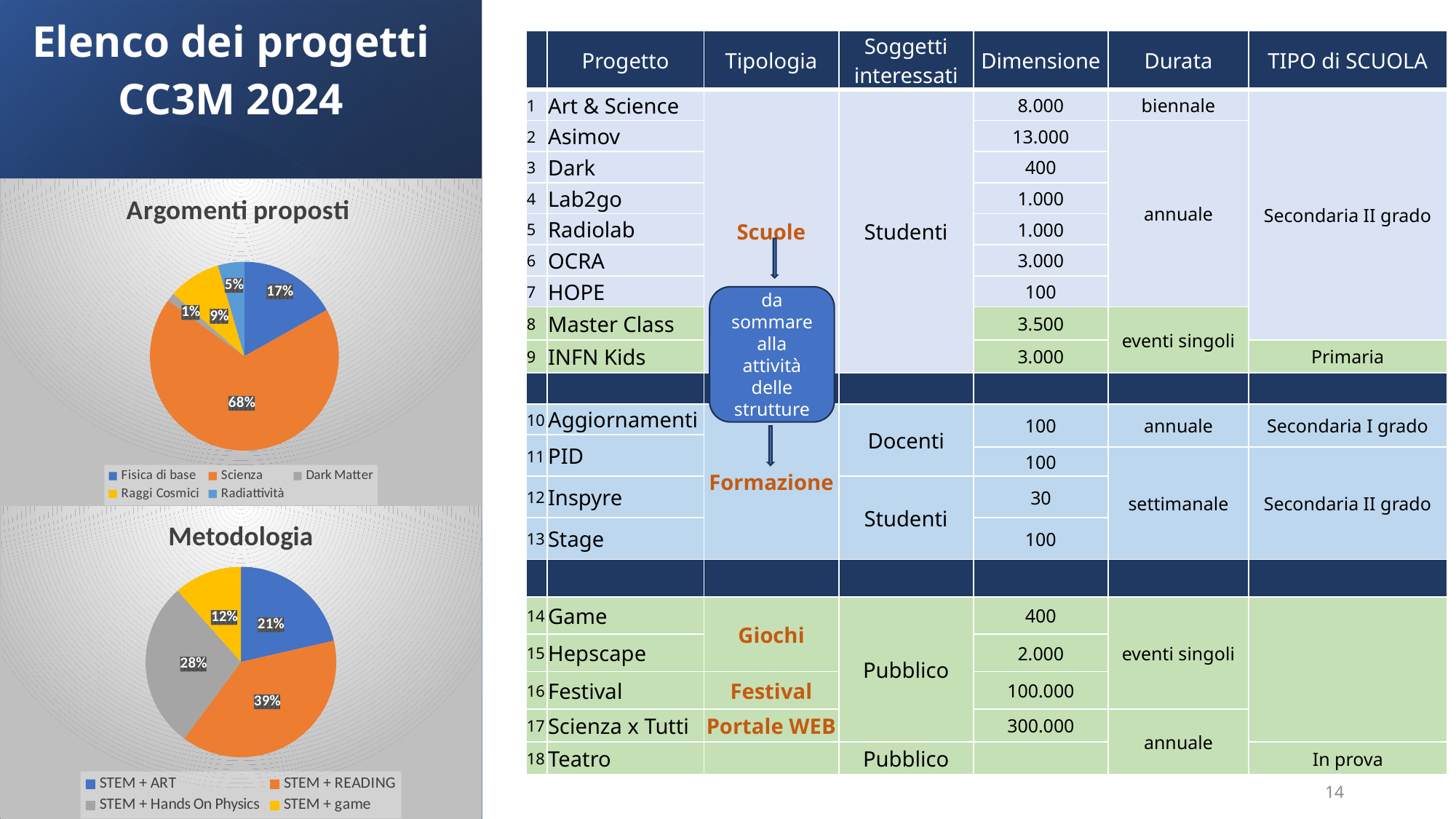
In the 'Metodologia' chart, what share does STEM + Hands On Physics have? 28% In the 'Argomenti proposti' chart, what is the difference between the shares of Raggi Cosmici and Radiattività? 4% In the 'Argomenti proposti' chart, which category has the largest share? Scienza In the 'Metodologia' chart, which is larger: STEM + ART or STEM + Hands On Physics? STEM + Hands On Physics In the 'Metodologia' chart, what is the difference between the shares of STEM + READING and STEM + ART? 18% What type of chart is the 'Metodologia' chart? pie chart In the 'Argomenti proposti' chart, which category has the smallest share? Dark Matter In the 'Argomenti proposti' chart, how many categories does the legend list? 5 In the 'Argomenti proposti' chart, what share does Scienza have? 68% In the 'Metodologia' chart, which category has the smallest share? STEM + game In the 'Metodologia' chart, what share does STEM + READING have? 39% In the 'Argomenti proposti' chart, what share does Fisica di base have? 17%